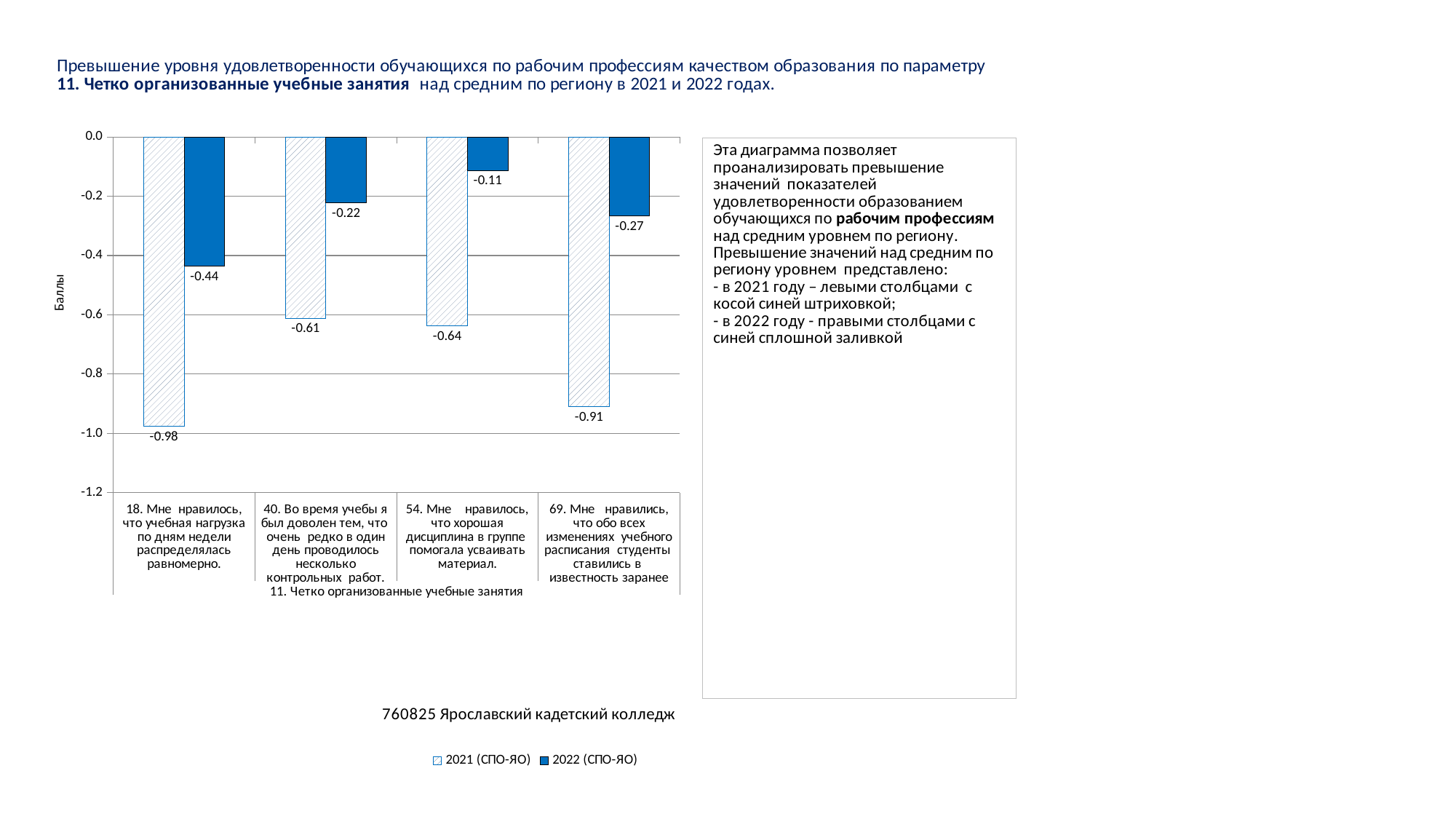
How many categories are shown on the x axis of the chart? 4 Which category has the lowest 2021 (СПО-ЯО) value? 18. Мне нравилось, что учебная нагрузка по дням недели распределялась равномерно. What is the 2022 (СПО-ЯО) value for category 54 ("Мне нравилось, что хорошая дисциплина в группе помогала усваивать материал")? -0.11 Which is larger for category 69: the 2021 (СПО-ЯО) value or the 2022 (СПО-ЯО) value? 2022 (СПО-ЯО) What is the 2022 (СПО-ЯО) value for category 69 ("Мне нравились, что обо всех изменениях учебного расписания студенты ставились в известность заранее")? -0.27 What is the 2021 (СПО-ЯО) value for category 40 ("Во время учебы я был доволен тем, что очень редко в один день проводилось несколько контрольных работ")? -0.61 What is the difference between the 2022 and 2021 values for category 18? 0.54 What is the label of the chart's vertical axis? Баллы What type of chart is shown on the slide? Bar chart Which category has the highest 2022 (СПО-ЯО) value? 54. Мне нравилось, что хорошая дисциплина в группе помогала усваивать материал. How many series does the chart legend list? 2 What is the 2021 (СПО-ЯО) value for category 18 ("Мне нравилось, что учебная нагрузка по дням недели распределялась равномерно")? -0.98